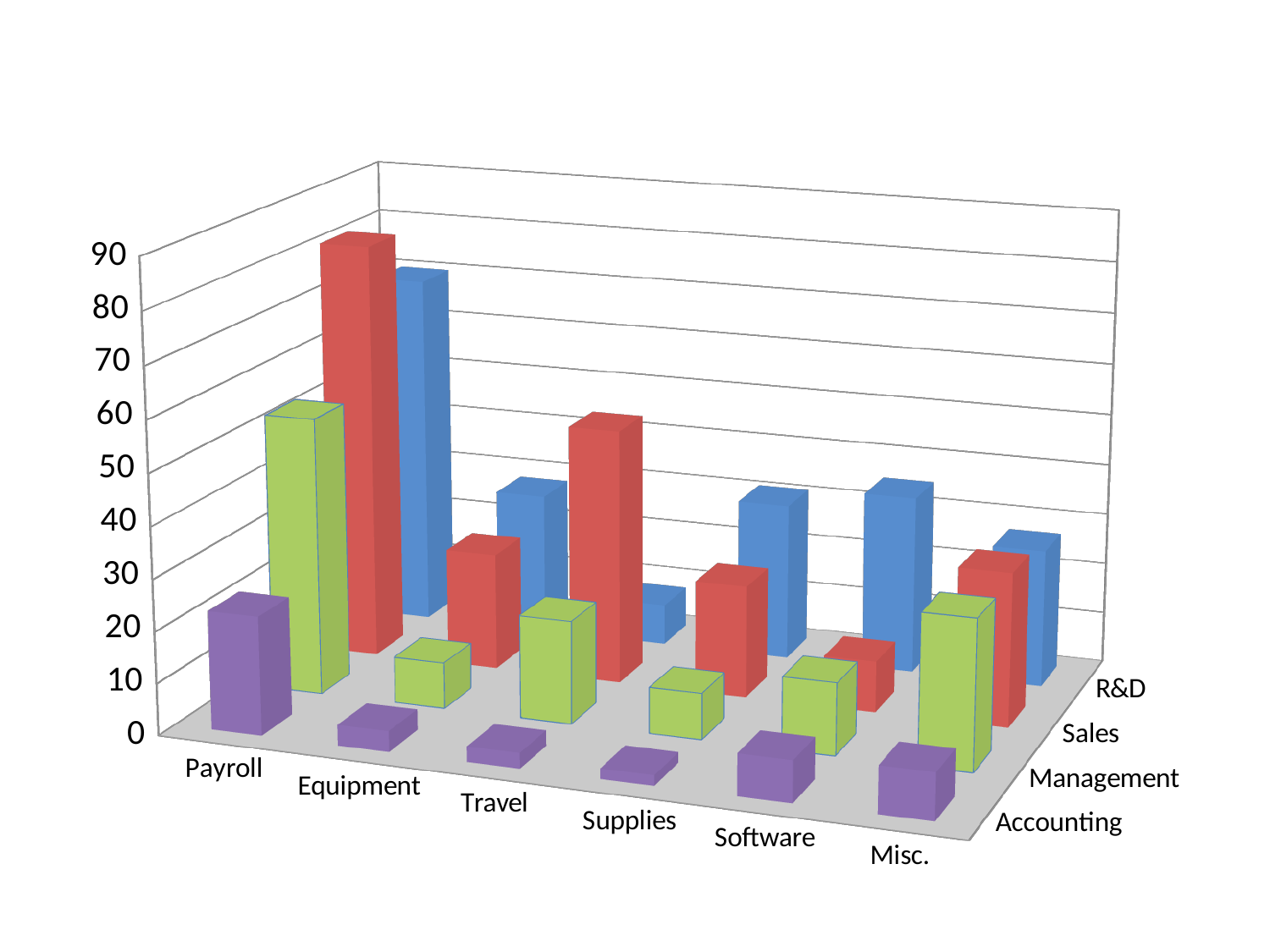
Which category has the highest Accounting value? Payroll Is the R&D value for Payroll greater or less than 50? greater Which category has the highest Sales value? Payroll How many series (departments) does the chart show? 4 Which category has the highest Management value? Payroll Which is larger, the Management value for Payroll or the Management value for Equipment? Payroll How many expense categories are shown along the x axis? 6 Is the Accounting value for Equipment greater or less than 20? less Which is larger, the Sales value for Travel or the Sales value for Software? Travel What kind of chart is shown on the slide? bar chart Is the Sales value for Payroll greater or less than 50? greater What colour are the bars for the Accounting series? purple